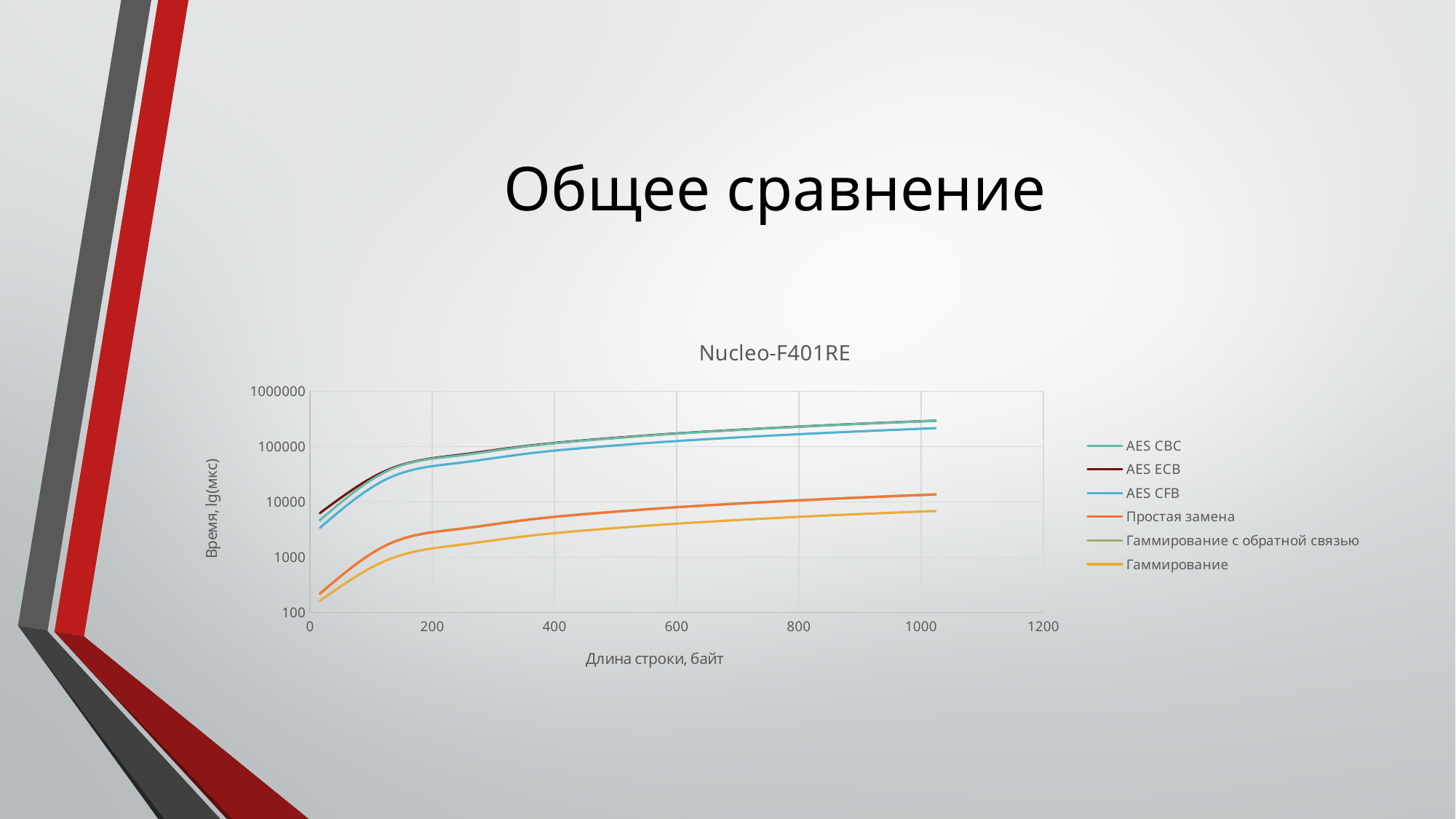
Is the value for AES CBC at a string length of 200 bytes greater or less than 100000? less What is the title of the chart? Nucleo-F401RE At a string length of 400 bytes, which is larger: Простая замена or Гаммирование? Простая замена Is the value for Простая замена at a string length of 1000 bytes greater or less than 10000? greater Is the value for Гаммирование at a string length of 1000 bytes greater or less than 10000? less How many series does the chart legend list? 6 At a string length of 600 bytes, which is larger: AES CFB or Гаммирование? AES CFB Which series has the lowest values across the whole chart? Гаммирование What is the label of the x axis? Длина строки, байт Do the values of the Гаммирование series rise or fall as the string length increases? rise What kind of chart is shown on the slide? line chart